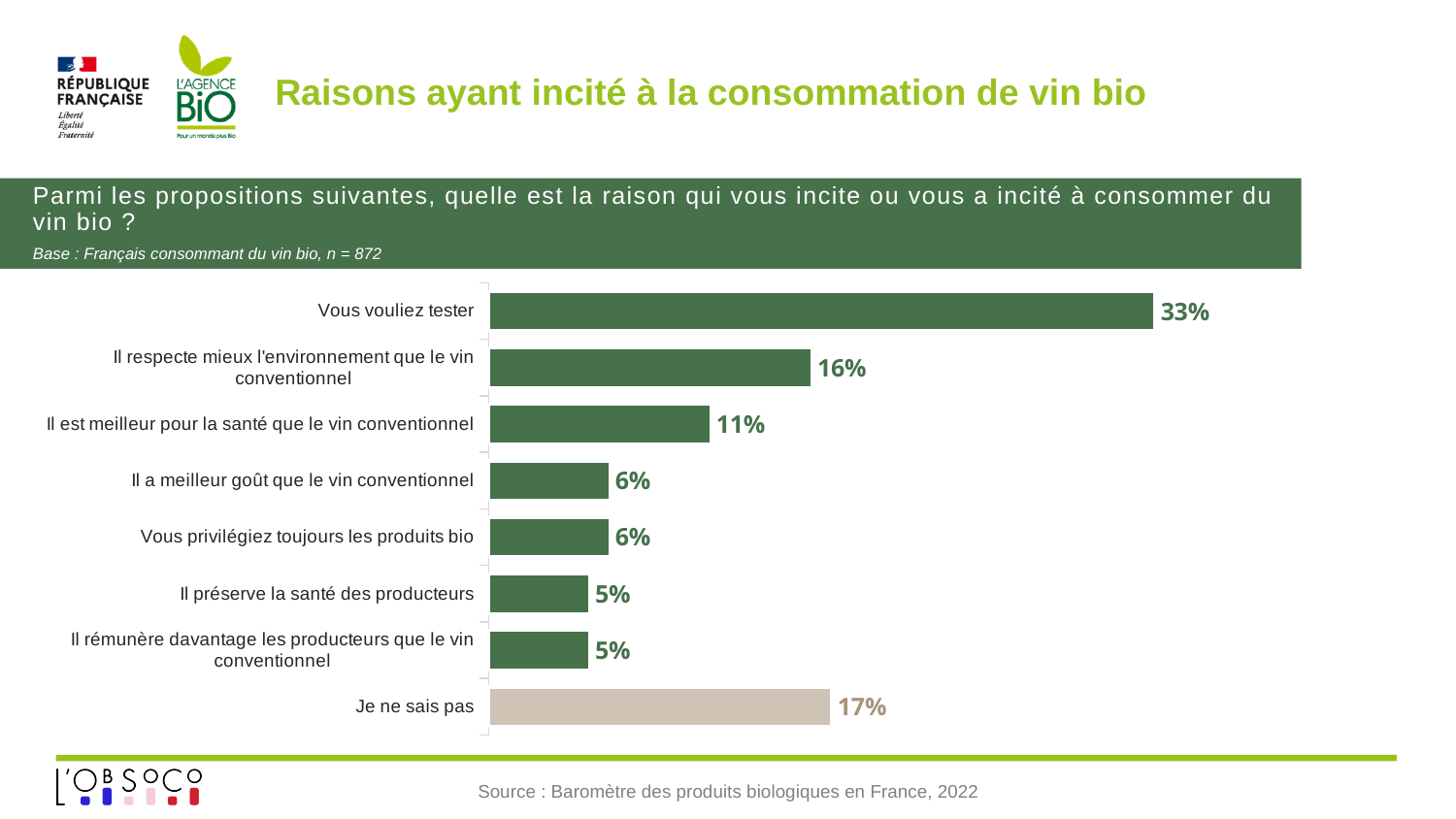
Which is larger: "Il a meilleur goût que le vin conventionnel" or "Il est meilleur pour la santé que le vin conventionnel"? Il est meilleur pour la santé que le vin conventionnel What is the value for "Il est meilleur pour la santé que le vin conventionnel"? 11% What kind of chart is shown on the slide? Bar chart Which reason has the highest value? Vous vouliez tester What is the value for "Il préserve la santé des producteurs"? 5% What is the value for "Il respecte mieux l'environnement que le vin conventionnel"? 16% How many categories are shown in the chart? 8 What is the difference between "Vous vouliez tester" and "Il respecte mieux l'environnement que le vin conventionnel"? 17% What percentage of respondents chose "Vous vouliez tester" as their reason? 33% What is the value for "Je ne sais pas"? 17% What is the difference between "Je ne sais pas" and "Il est meilleur pour la santé que le vin conventionnel"? 6% Which bar is shown in a different colour (beige) from the others? Je ne sais pas